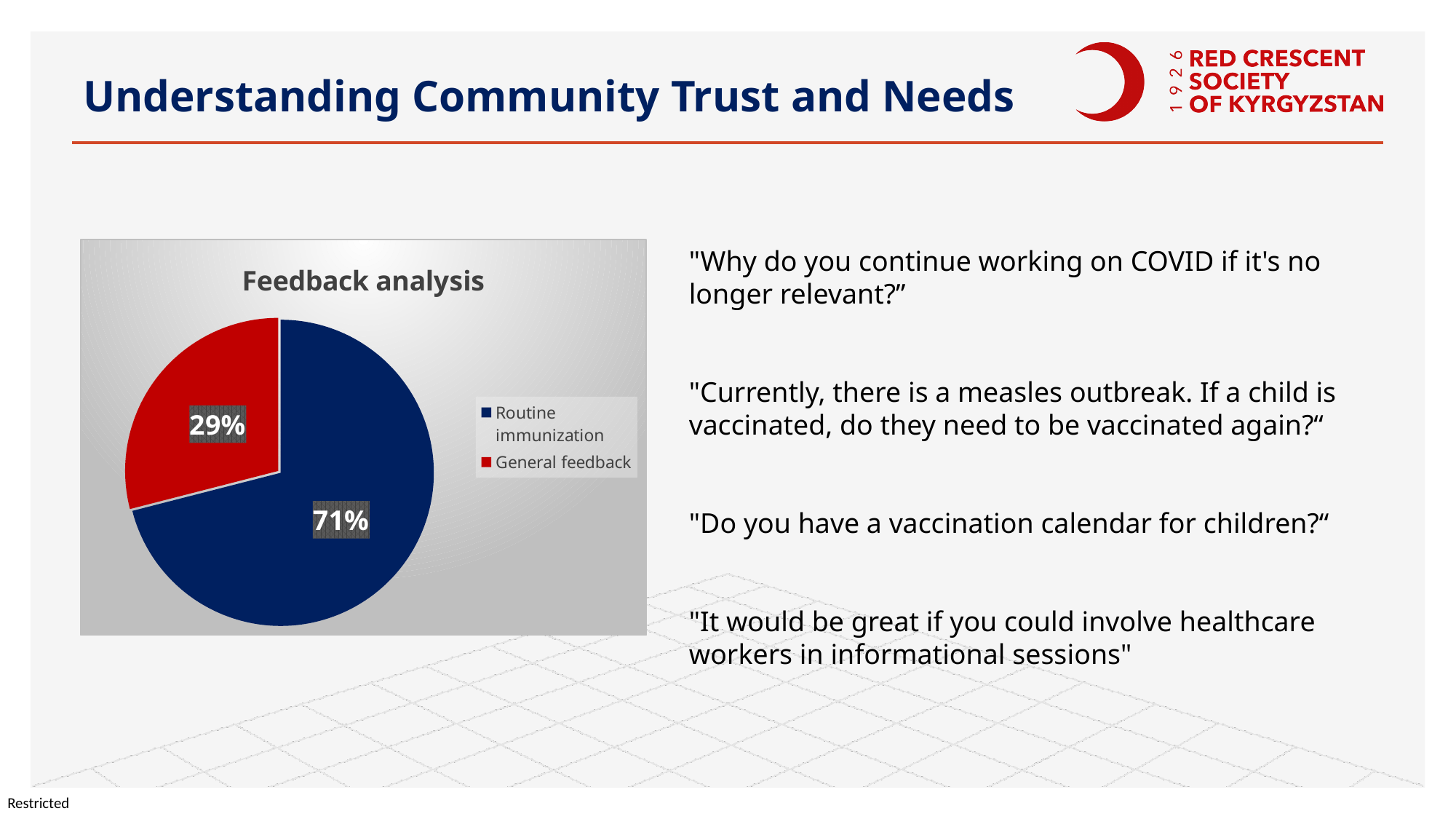
What is the title of the chart? Feedback analysis How many slices does the pie chart have? 2 What is the difference in percentage points between Routine immunization and General feedback? 42 Which category has the smallest slice of the pie? General feedback What share of the pie does Routine immunization represent? 71% Which category has the largest slice of the pie? Routine immunization How many entries does the legend list? 2 What share of the pie does General feedback represent? 29% What colour is the General feedback slice? red Which is larger, the slice for Routine immunization or the slice for General feedback? Routine immunization What type of chart is shown on the slide? pie chart Is the value for General feedback greater or less than 50%? less